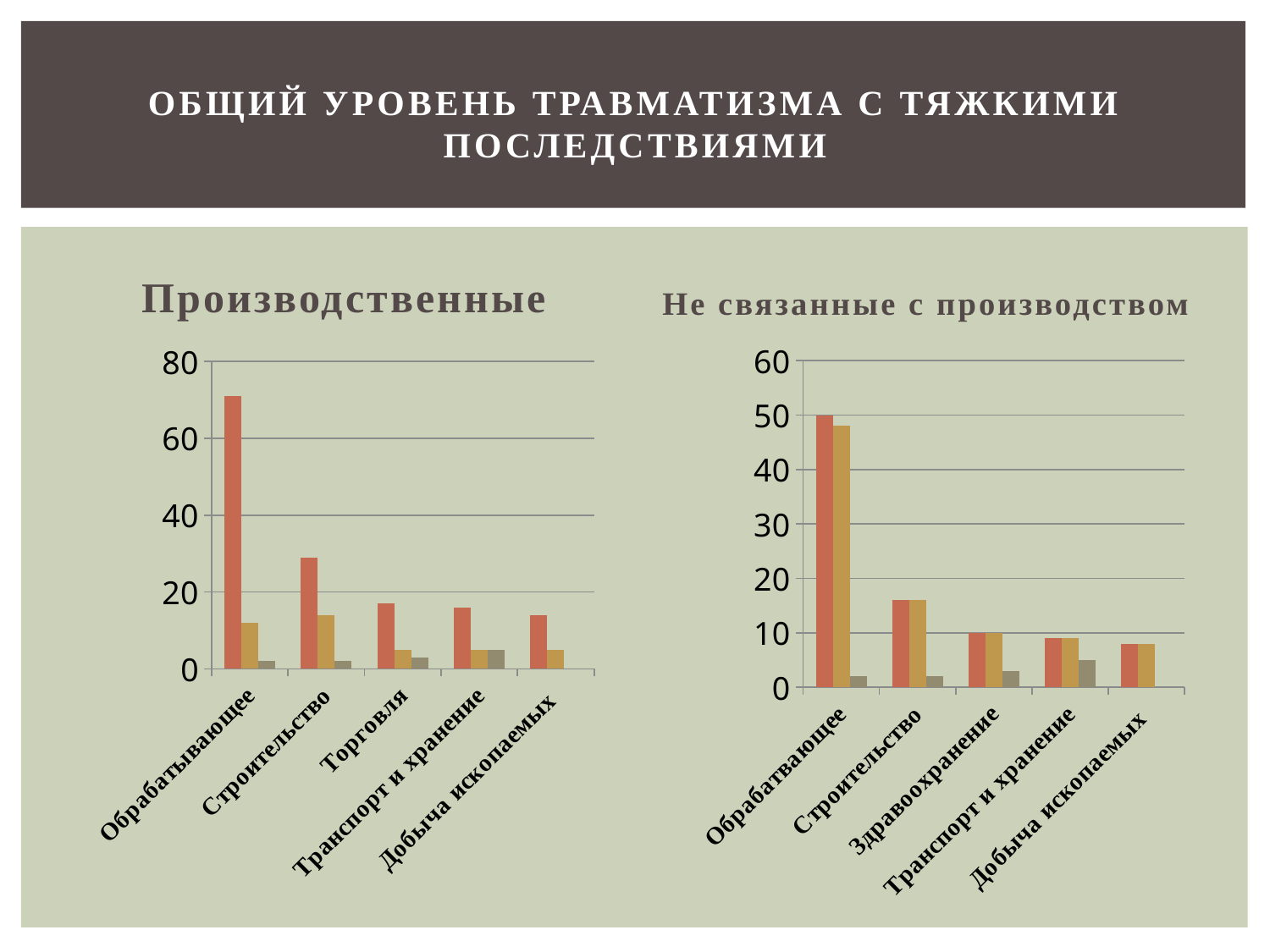
In the left chart "Производственные", is the tallest bar for Строительство greater or less than 40? less In the left chart "Производственные", which category has the tallest bar? Обрабатывающее In the left chart "Производственные", is the tallest bar for Обрабатывающее greater or less than 60? greater In the right chart "Не связанные с производством", is the tallest bar for Обрабатвающее greater or less than 40? greater What kind of chart is the left chart titled "Производственные"? bar chart What kind of chart is the right chart titled "Не связанные с производством"? bar chart In the right chart "Не связанные с производством", which category has the tallest bar? Обрабатвающее How many categories are shown on the x axis of the left chart "Производственные"? 5 In the left chart "Производственные", which is larger: the tallest bar for Обрабатывающее or the tallest bar for Строительство? Обрабатывающее What is the highest value shown on the vertical axis of the right chart "Не связанные с производством"? 60 How many categories are shown on the x axis of the right chart "Не связанные с производством"? 5